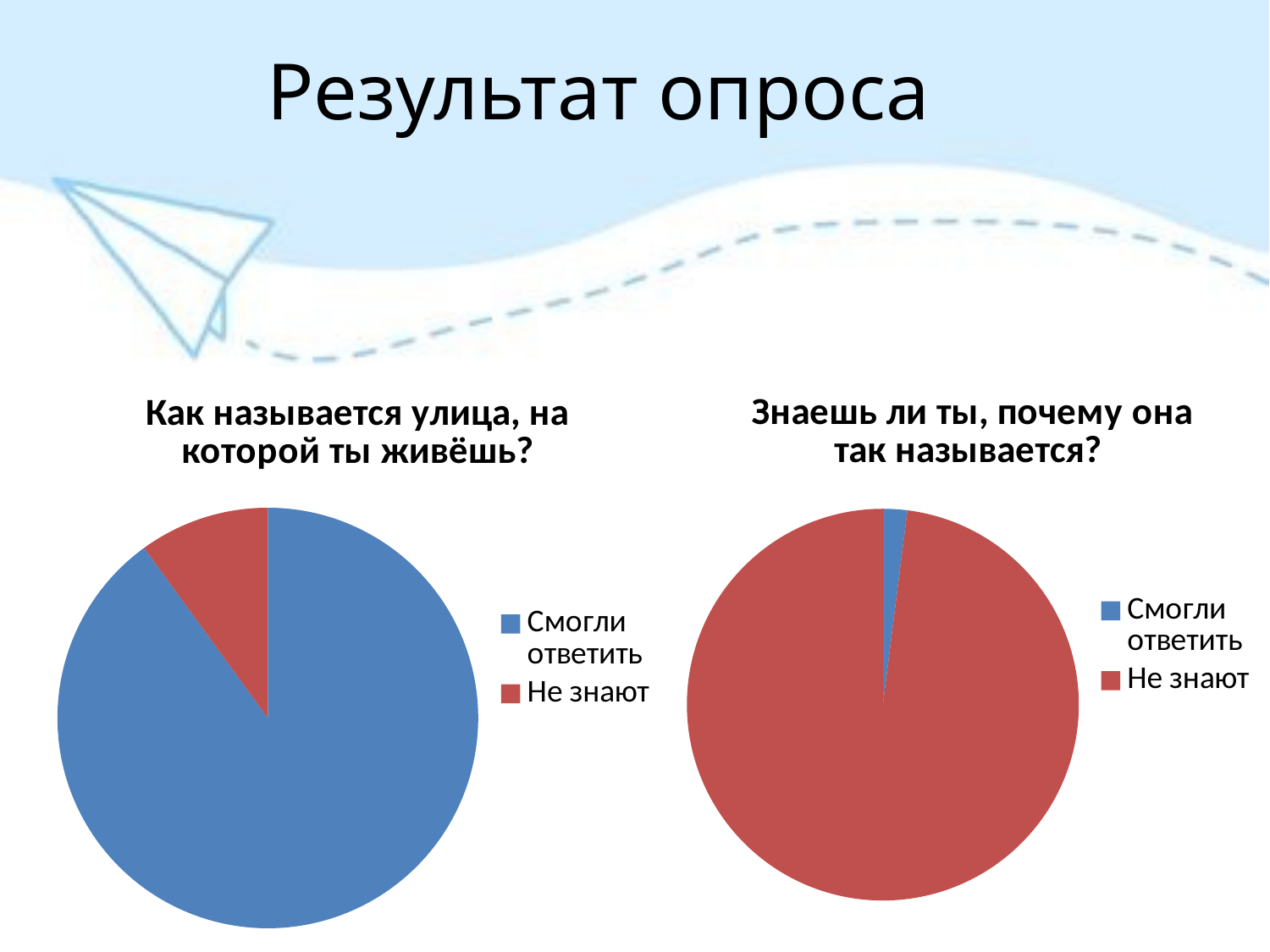
What kind of chart is the right chart titled "Знаешь ли ты, почему она так называется?"? Pie chart What is the title of the chart on the left side of the slide? Как называется улица, на которой ты живёшь? In the left chart "Как называется улица, на которой ты живёшь?", which category has the smallest slice? Не знают In the right chart "Знаешь ли ты, почему она так называется?", which category has the smallest slice? Смогли ответить How many entries does the legend of the right chart "Знаешь ли ты, почему она так называется?" list? 2 What kind of chart is the left chart titled "Как называется улица, на которой ты живёшь?"? Pie chart In the right chart "Знаешь ли ты, почему она так называется?", which is larger: "Смогли ответить" or "Не знают"? Не знают In the right chart "Знаешь ли ты, почему она так называется?", which category has the largest slice? Не знают In the left chart "Как называется улица, на которой ты живёшь?", which is larger: "Смогли ответить" or "Не знают"? Смогли ответить How many slices does the left chart "Как называется улица, на которой ты живёшь?" have? 2 In the left chart "Как называется улица, на которой ты живёшь?", which category has the largest slice? Смогли ответить In the right chart "Знаешь ли ты, почему она так называется?", what colour is the "Не знают" slice? Red